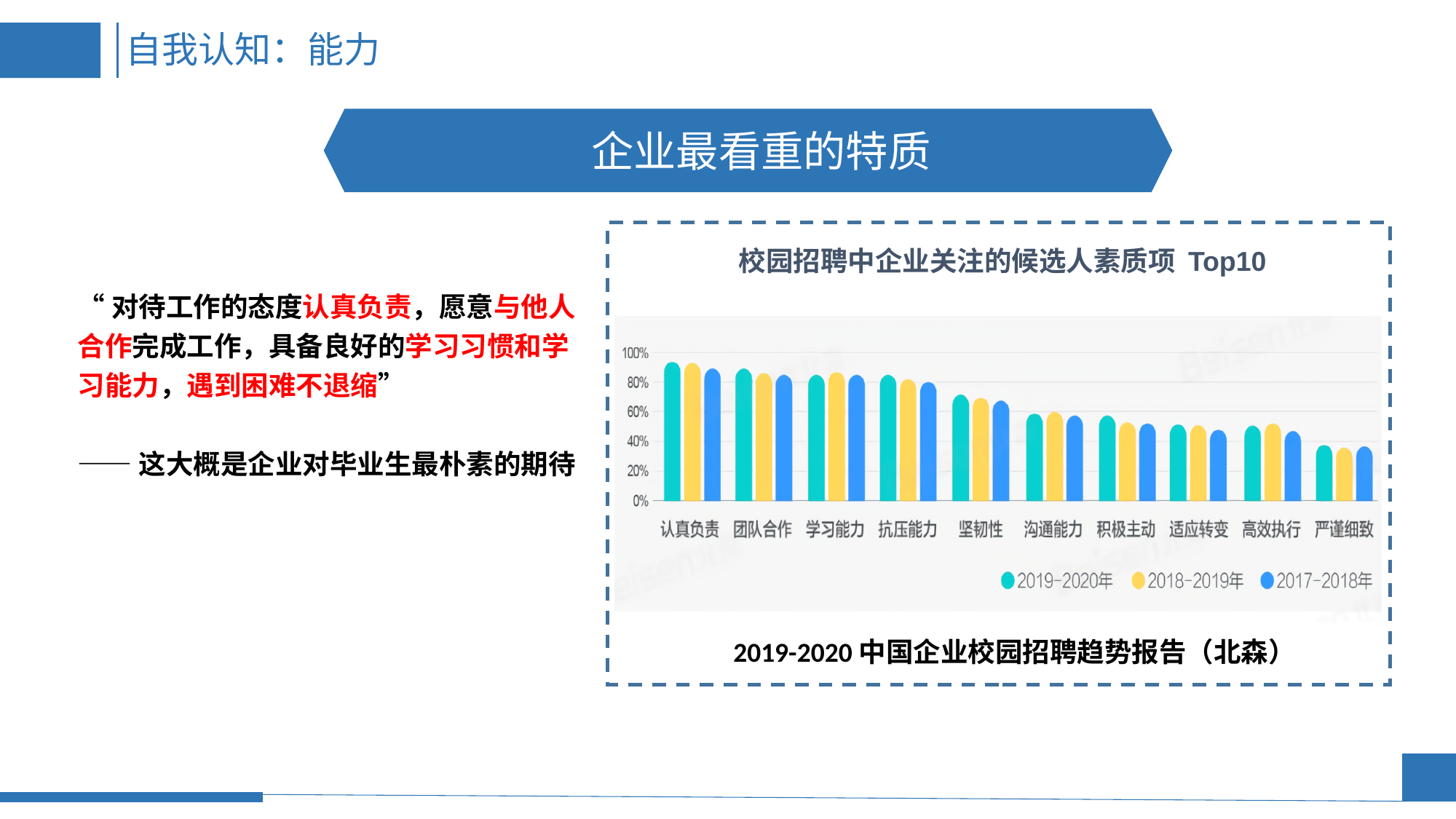
Is the 2017-2018年 value for 适应转变 greater or less than 40%? greater Do the values generally rise or fall moving from left to right along the x axis? fall Which category has the lowest value for the 2019-2020年 series? 严谨细致 How many categories (quality items) are shown on the x axis of the chart? 10 For the 2019-2020年 series, which is larger: 抗压能力 or 坚韧性? 抗压能力 How many series does the chart's legend list? 3 Is the 2019-2020年 value for 坚韧性 greater or less than 60%? greater Is the 2019-2020年 value for 严谨细致 greater or less than 40%? less What kind of chart is shown on the slide? bar chart Which category has the highest value for the 2019-2020年 series? 认真负责 What is the title of the chart? 校园招聘中企业关注的候选人素质项 Top10